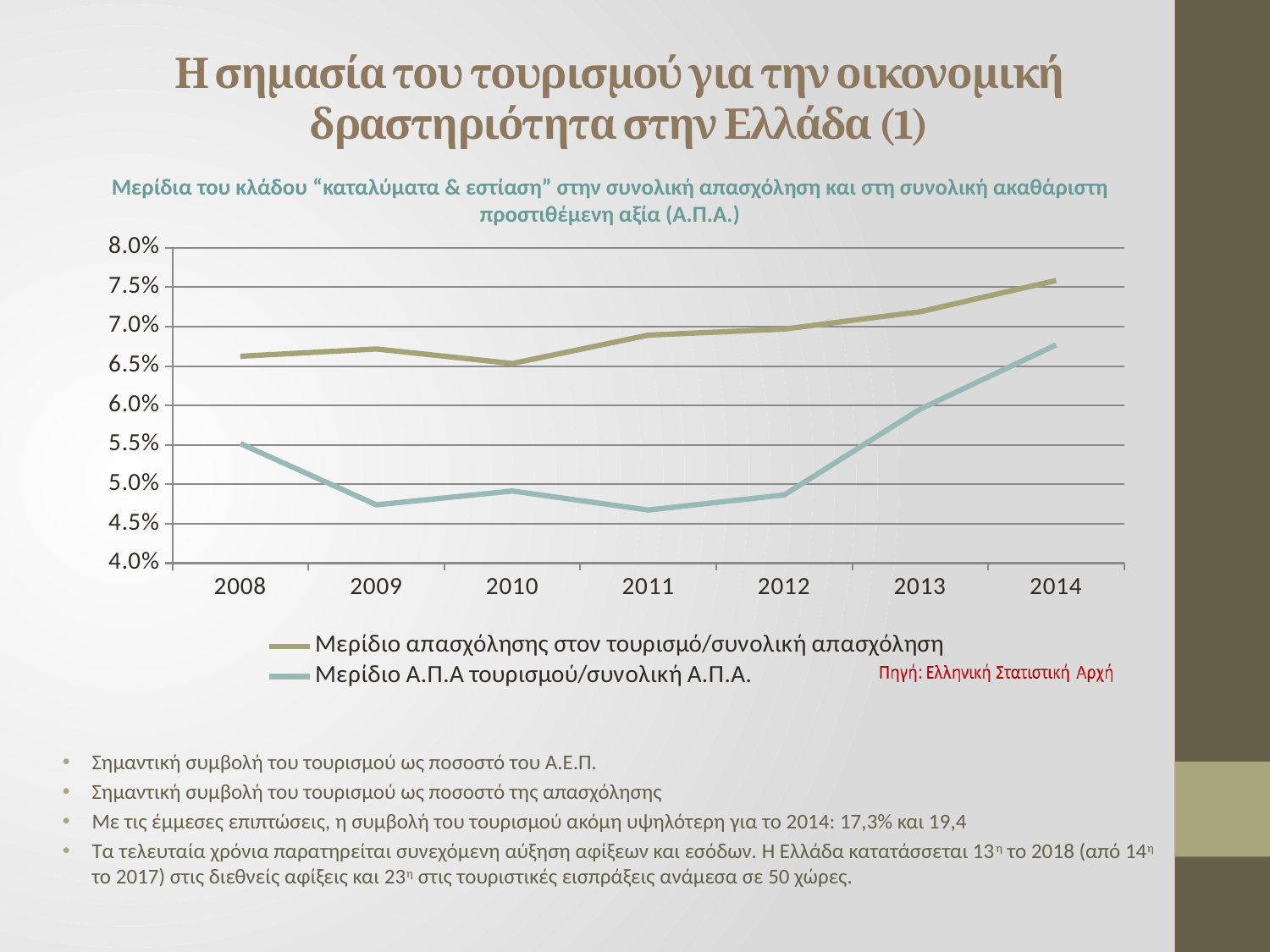
In which year is the value for 'Μερίδιο απασχόλησης στον τουρισμό/συνολική απασχόληση' highest? 2014 Is the value for 'Μερίδιο Α.Π.Α τουρισμού/συνολική Α.Π.Α.' in 2008 greater or less than 5.0%? greater How many series does the legend list? 2 How many years are shown on the x axis? 7 What source is cited below the chart? Ελληνική Στατιστική Αρχή In 2014, which series has the larger value: 'Μερίδιο απασχόλησης στον τουρισμό/συνολική απασχόληση' or 'Μερίδιο Α.Π.Α τουρισμού/συνολική Α.Π.Α.'? Μερίδιο απασχόλησης στον τουρισμό/συνολική απασχόληση Does the value for 'Μερίδιο Α.Π.Α τουρισμού/συνολική Α.Π.Α.' rise or fall from 2012 to 2014? rise What kind of chart is shown on the slide? line chart Is the value for 'Μερίδιο απασχόλησης στον τουρισμό/συνολική απασχόληση' in 2010 greater or less than 7.0%? less Is the value for 'Μερίδιο απασχόλησης στον τουρισμό/συνολική απασχόληση' in 2014 greater or less than 7.0%? greater In which year is the value for 'Μερίδιο Α.Π.Α τουρισμού/συνολική Α.Π.Α.' highest? 2014